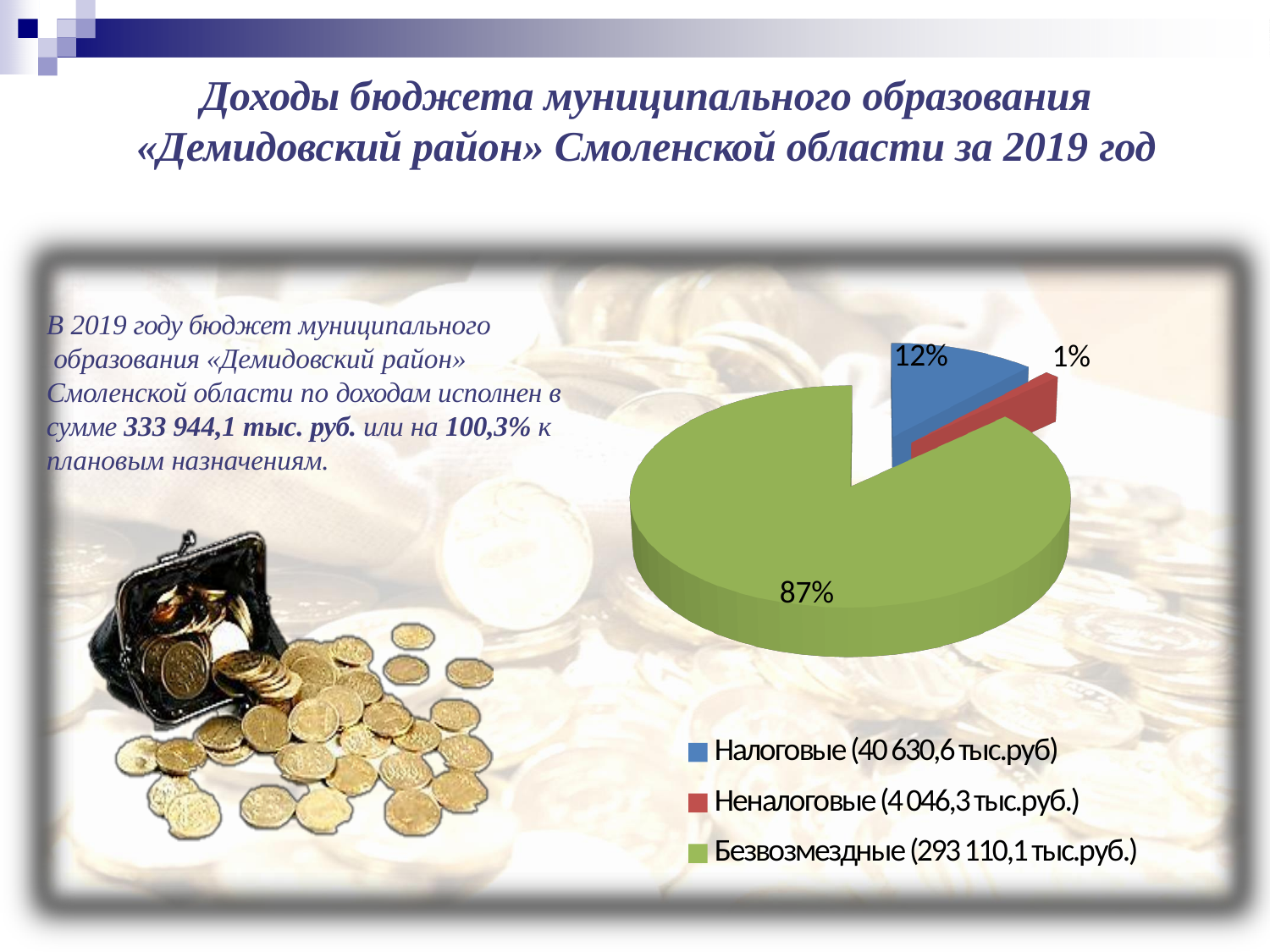
What share of the pie does the Безвозмездные slice represent? 87% What amount in thousand rubles does the legend give for Налоговые? 40 630,6 тыс.руб What colour is the Неналоговые slice in the pie chart? red Which category has the smallest slice of the pie? Неналоговые What is the difference in percentage points between the Безвозмездные slice and the Налоговые slice? 75 Which category has the largest slice of the pie? Безвозмездные What share of the pie does the Неналоговые slice represent? 1% What amount in thousand rubles does the legend give for Безвозмездные? 293 110,1 тыс.руб. What kind of chart is shown on the slide? pie chart Which is larger, the Налоговые slice or the Неналоговые slice? Налоговые How many slices does the pie chart have? 3 What share of the pie does the Налоговые slice represent? 12%